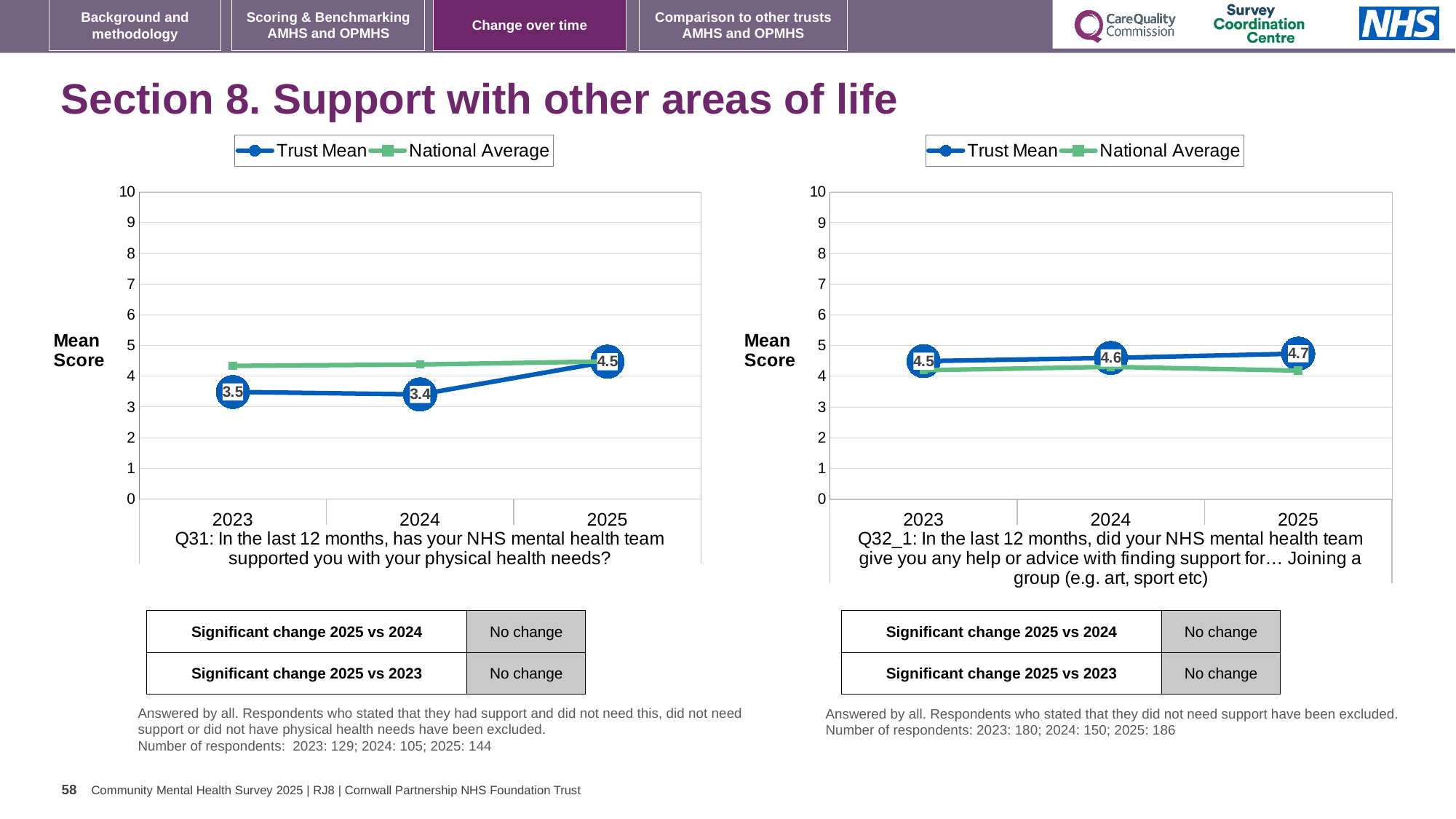
On the left chart (Q31), is the National Average for 2023 greater or less than 4? greater On the right chart (Q32_1), what is the Trust Mean for 2024? 4.6 On the left chart (Q31), what is the difference between the Trust Mean for 2025 and 2024? 1.1 On the left chart (Q31), what is the Trust Mean for 2023? 3.5 How many series does the legend of the left chart (Q31) list? 2 How many years are plotted on the x axis of the right chart (Q32_1)? 3 What kind of chart is the right chart (Q32_1)? Line chart On the right chart (Q32_1), is the Trust Mean for 2023 or 2025 larger? 2025 On the right chart (Q32_1), what is the Trust Mean for 2025? 4.7 On the left chart (Q31), which year has the lowest Trust Mean? 2024 On the left chart (Q31), what is the Trust Mean for 2025? 4.5 On the right chart (Q32_1), which year has the highest Trust Mean? 2025